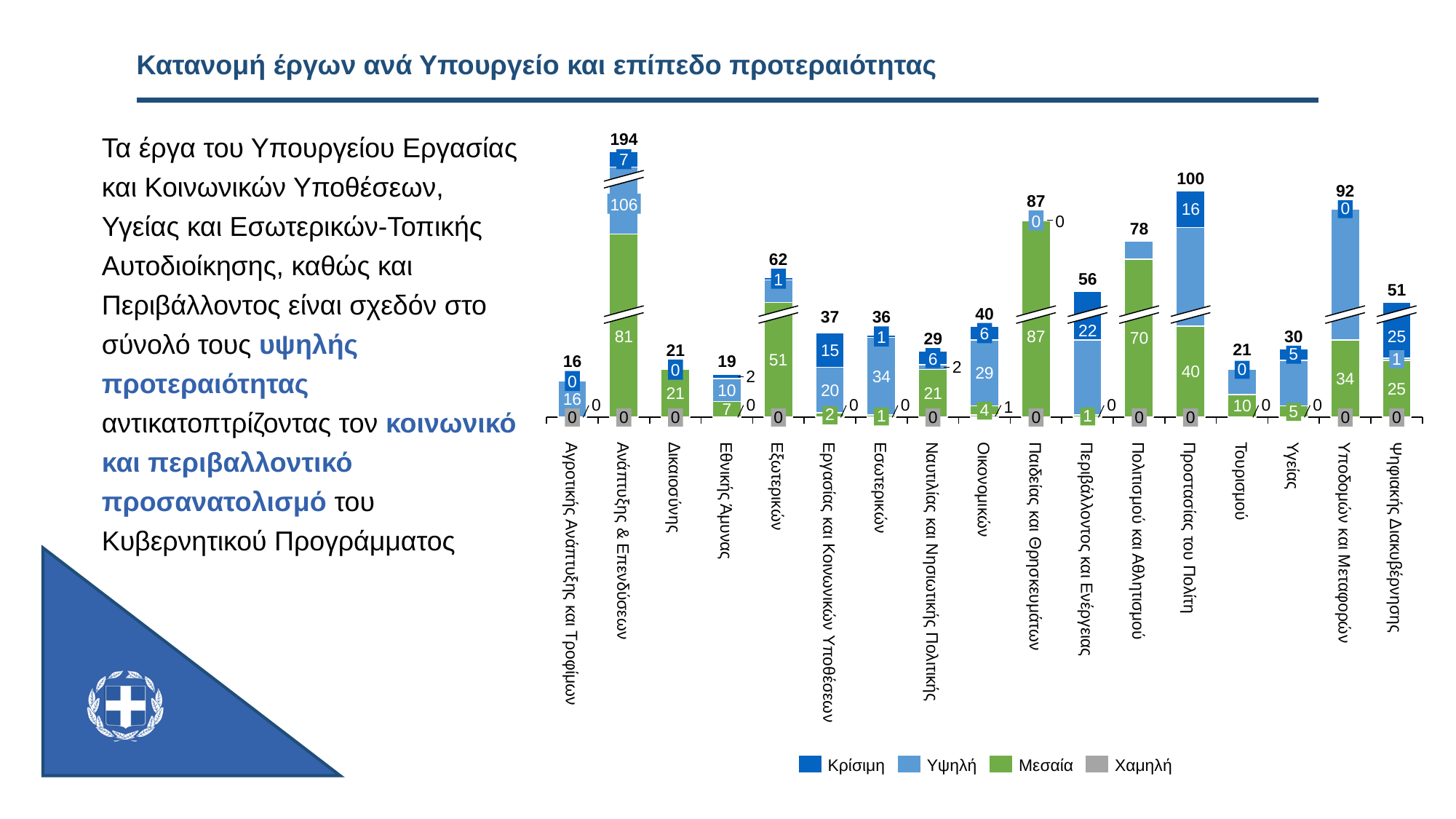
What is the Μεσαία value for Παιδείας και Θρησκευμάτων? 87 Which legend entry is shown in green? Μεσαία How many series does the legend list? 4 Which has a larger total, Εξωτερικών or Περιβάλλοντος και Ενέργειας? Εξωτερικών What kind of chart is shown on the slide? Stacked bar chart What is the difference between the totals of Υποδομών και Μεταφορών and Πολιτισμού και Αθλητισμού? 14 How many ministries (categories) are shown on the x axis? 17 What is the Υψηλή value for Ανάπτυξης & Επενδύσεων? 106 Which ministry has the lowest total number of projects? Αγροτικής Ανάπτυξης και Τροφίμων What is the total number of projects for Προστασίας του Πολίτη? 100 What is the Κρίσιμη value for Εργασίας και Κοινωνικών Υποθέσεων? 15 Which ministry has the highest total number of projects? Ανάπτυξης & Επενδύσεων